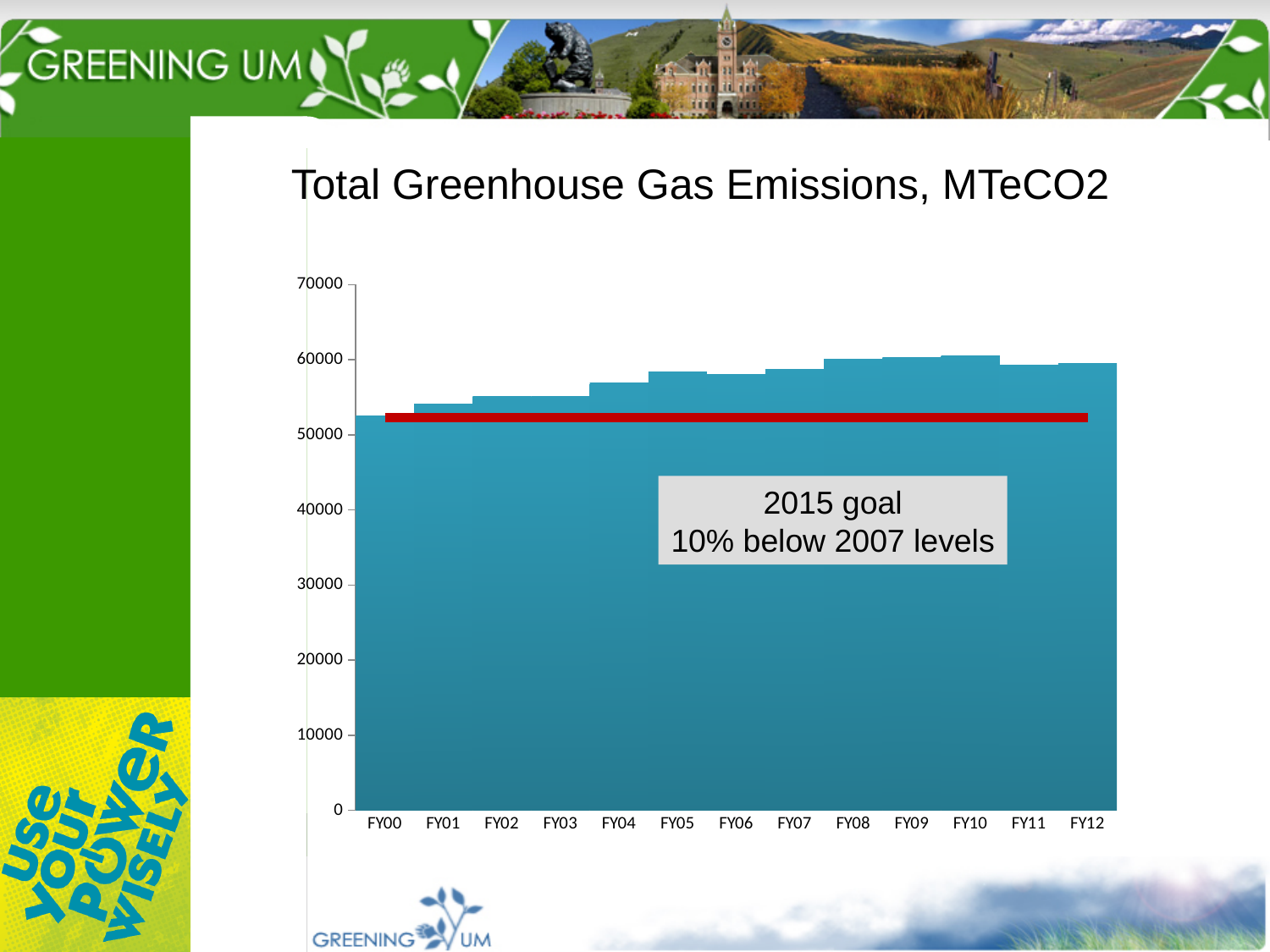
What is the title of the chart? Total Greenhouse Gas Emissions, MTeCO2 Which fiscal year has the lowest total greenhouse gas emissions? FY00 Is the value for FY08 greater or less than 50000? greater Do emissions generally rise or fall from FY00 to FY10? rise What does the text box on the chart say the 2015 goal is? 10% below 2007 levels Is the value for FY00 greater or less than 60000? less Which is larger, the value for FY02 or the value for FY08? FY08 Which is larger, the value for FY00 or the value for FY10? FY10 Is the value for FY00 greater or less than 50000? greater What kind of chart is shown on the slide? bar chart (with a line overlaid) How many fiscal years are shown on the x axis of the chart? 13